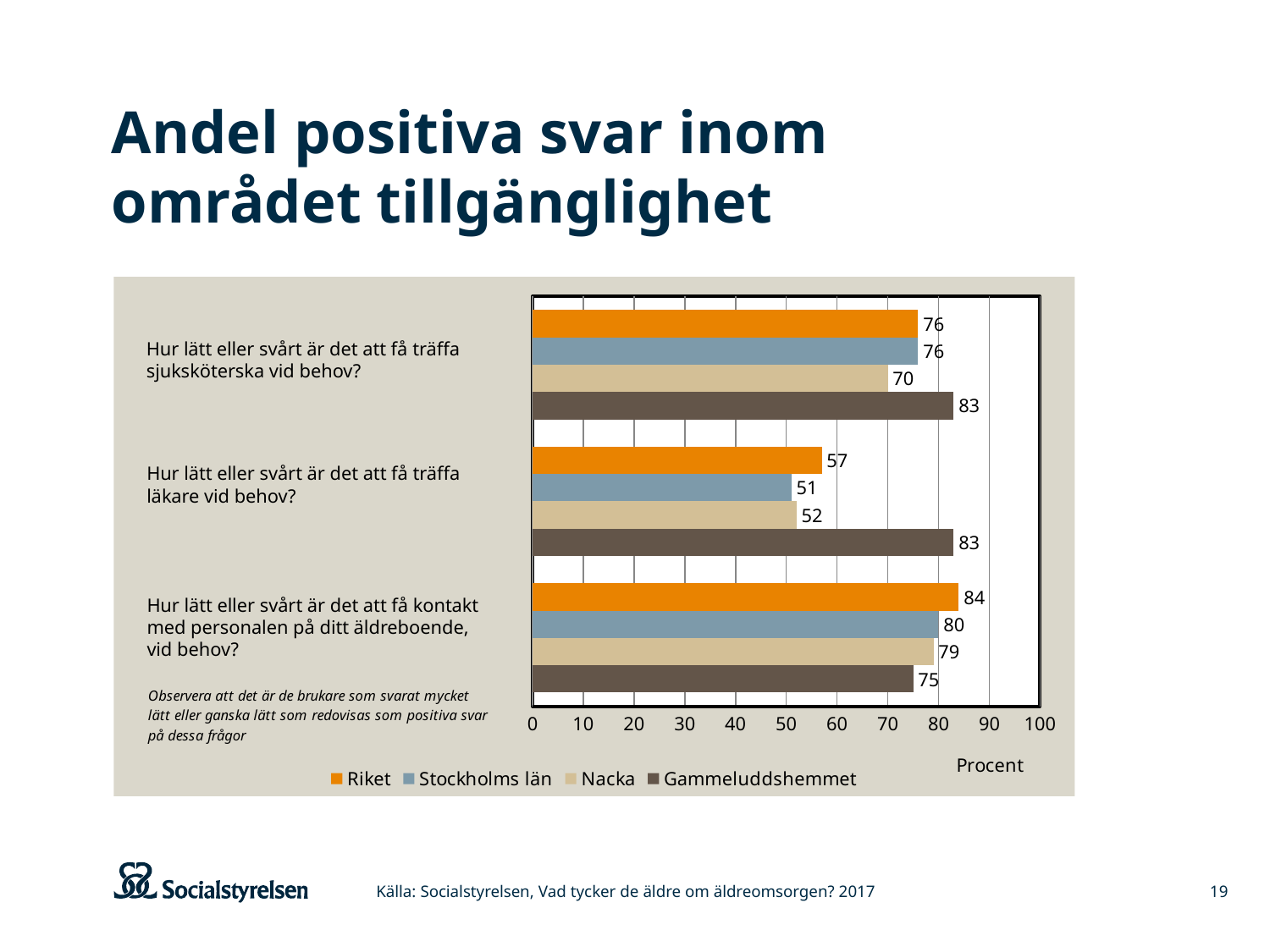
For 'Hur lätt eller svårt är det att få kontakt med personalen på ditt äldreboende, vid behov?', which is larger: Stockholms län or Gammeluddshemmet? Stockholms län What is the value for Riket for 'Hur lätt eller svårt är det att få kontakt med personalen på ditt äldreboende, vid behov?' 84 Which series has the highest value for 'Hur lätt eller svårt är det att få kontakt med personalen på ditt äldreboende, vid behov?' Riket What is the value for Nacka for 'Hur lätt eller svårt är det att få träffa sjuksköterska vid behov?' 70 How many series does the legend list? 4 Which series has the lowest value for 'Hur lätt eller svårt är det att få träffa läkare vid behov?' Stockholms län What is the difference between Gammeluddshemmet and Riket for 'Hur lätt eller svårt är det att få träffa läkare vid behov?' 26 What is the axis label shown below the horizontal axis? Procent What kind of chart is shown on the slide? Bar chart What is the value for Gammeluddshemmet for 'Hur lätt eller svårt är det att få träffa läkare vid behov?' 83 What is the value for Stockholms län for 'Hur lätt eller svårt är det att få träffa sjuksköterska vid behov?' 76 How many question categories are plotted on the chart? 3